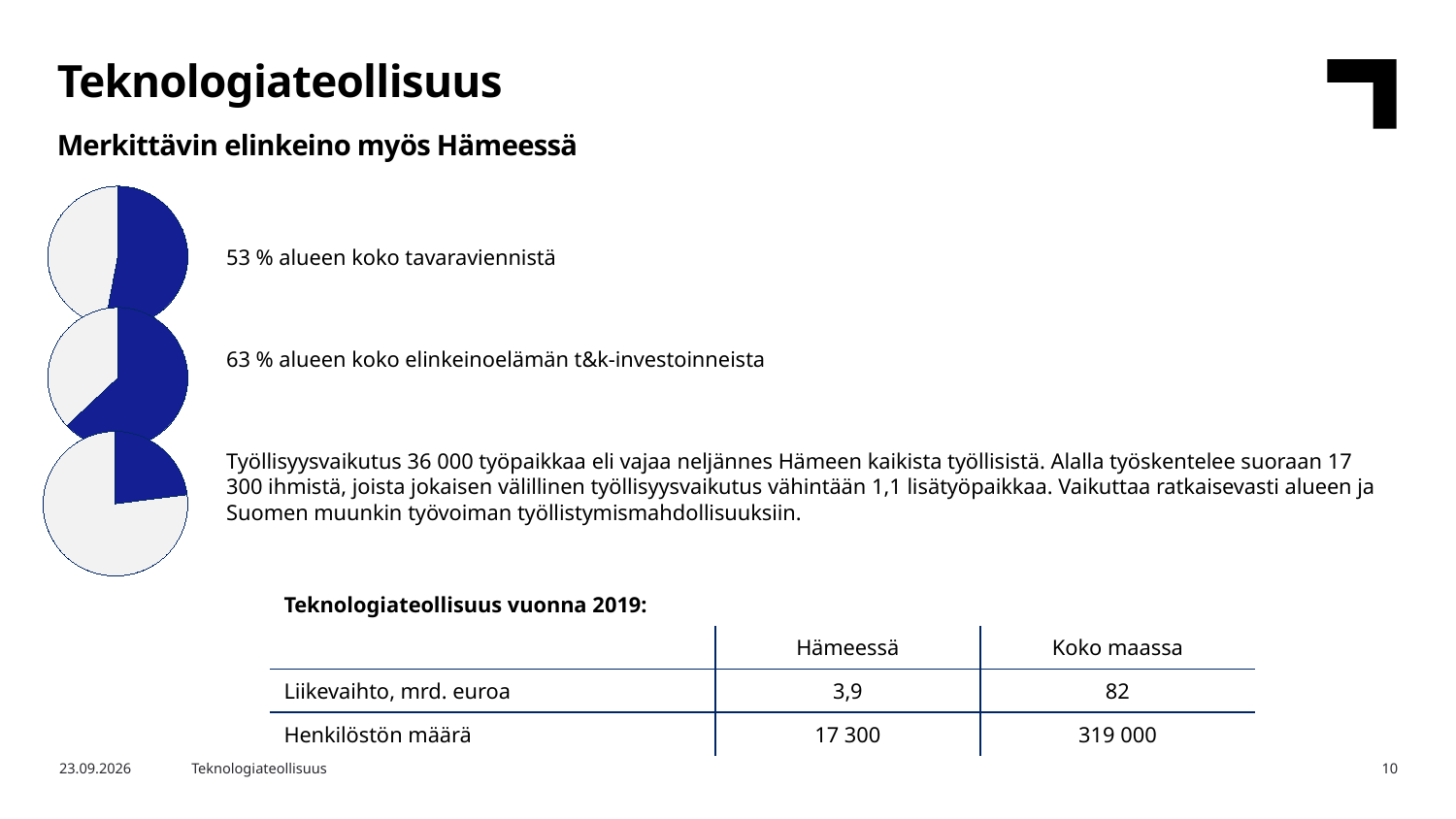
Which pie chart has the largest dark blue slice: the top, middle or bottom one? Middle According to the text next to the top pie chart, what share of the region's total goods exports does the technology industry account for? 53 % What is the difference in percentage points between the shares shown for the middle pie chart (63 %) and the top pie chart (53 %)? 10 percentage points What colour is the highlighted slice in each pie chart? Dark blue Is the dark blue slice of the bottom pie chart greater or less than 50% of the pie? less Which has a larger dark blue slice, the top pie chart or the bottom pie chart? Top How many pie charts are on the slide? 3 How many slices does each pie chart have? 2 According to the text next to the middle pie chart, what share of the region's business R&D investments does the technology industry account for? 63 % Is the dark blue slice of the middle pie chart greater or less than 50% of the pie? greater Which pie chart has the smallest dark blue slice: the top, middle or bottom one? Bottom What kind of charts are shown on the left side of the slide? Pie charts